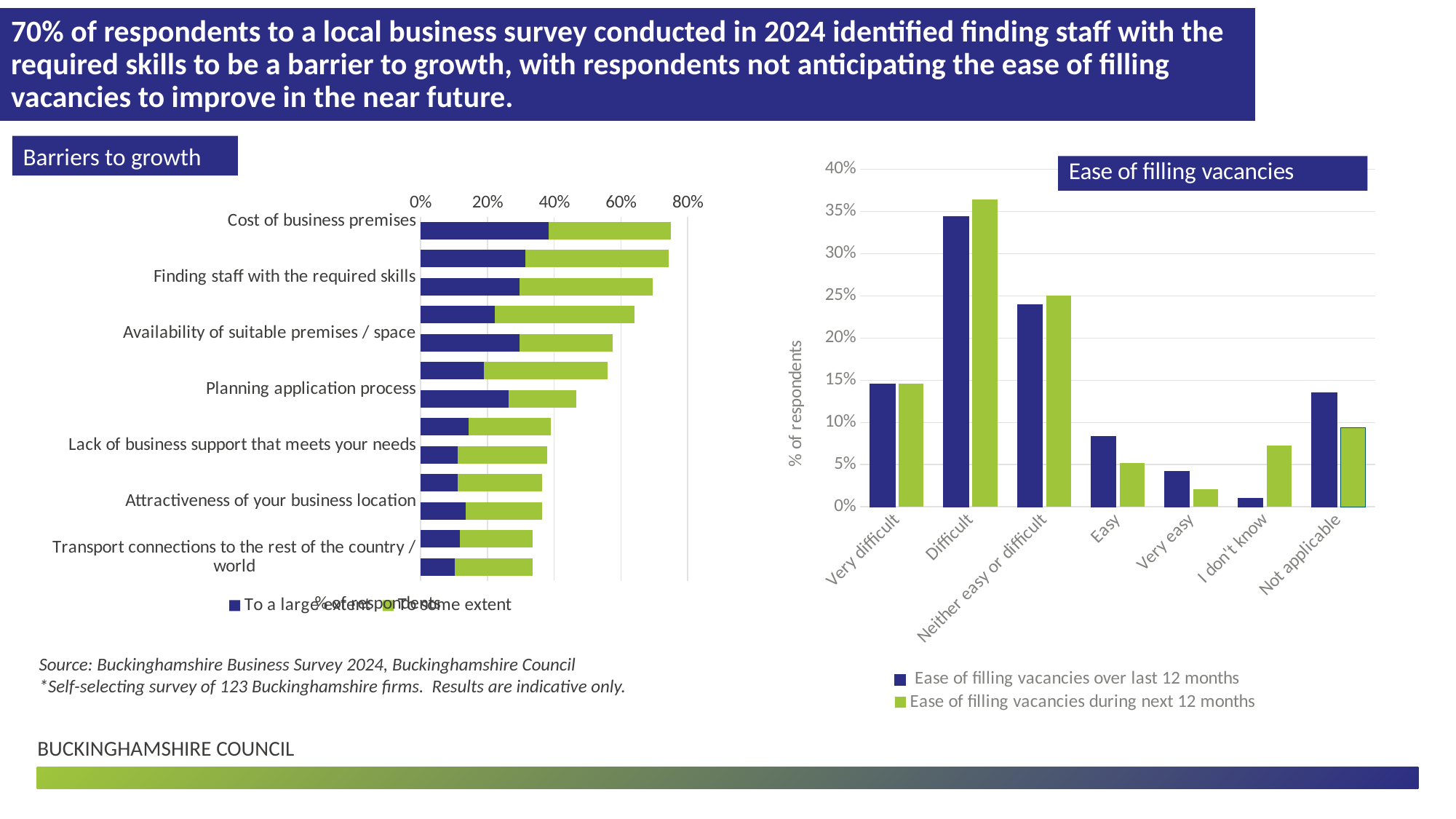
How many categories are shown on the x axis of the 'Ease of filling vacancies' chart? 7 In the 'Ease of filling vacancies' chart, is the value for 'Neither easy or difficult' over the last 12 months greater or less than 20%? greater In the 'Ease of filling vacancies' chart, is the value for 'Very easy' during the next 12 months greater or less than 5%? less In the 'Ease of filling vacancies' chart, for the 'Easy' category, which series is larger: over last 12 months or during next 12 months? Ease of filling vacancies over last 12 months What are the two legend entries of the 'Barriers to growth' chart? To a large extent; To some extent In the 'Ease of filling vacancies' chart, which category has the highest value for 'Ease of filling vacancies over last 12 months'? Difficult What kind of chart is the 'Barriers to growth' chart? bar chart In the 'Ease of filling vacancies' chart, for the 'I don't know' category, which series is larger: over last 12 months or during next 12 months? Ease of filling vacancies during next 12 months What kind of chart is the 'Ease of filling vacancies' chart? bar chart How many series does the legend of the 'Ease of filling vacancies' chart list? 2 In the 'Ease of filling vacancies' chart, which category has the highest value for 'Ease of filling vacancies during next 12 months'? Difficult In the 'Ease of filling vacancies' chart, which category has the lowest value for 'Ease of filling vacancies over last 12 months'? I don't know